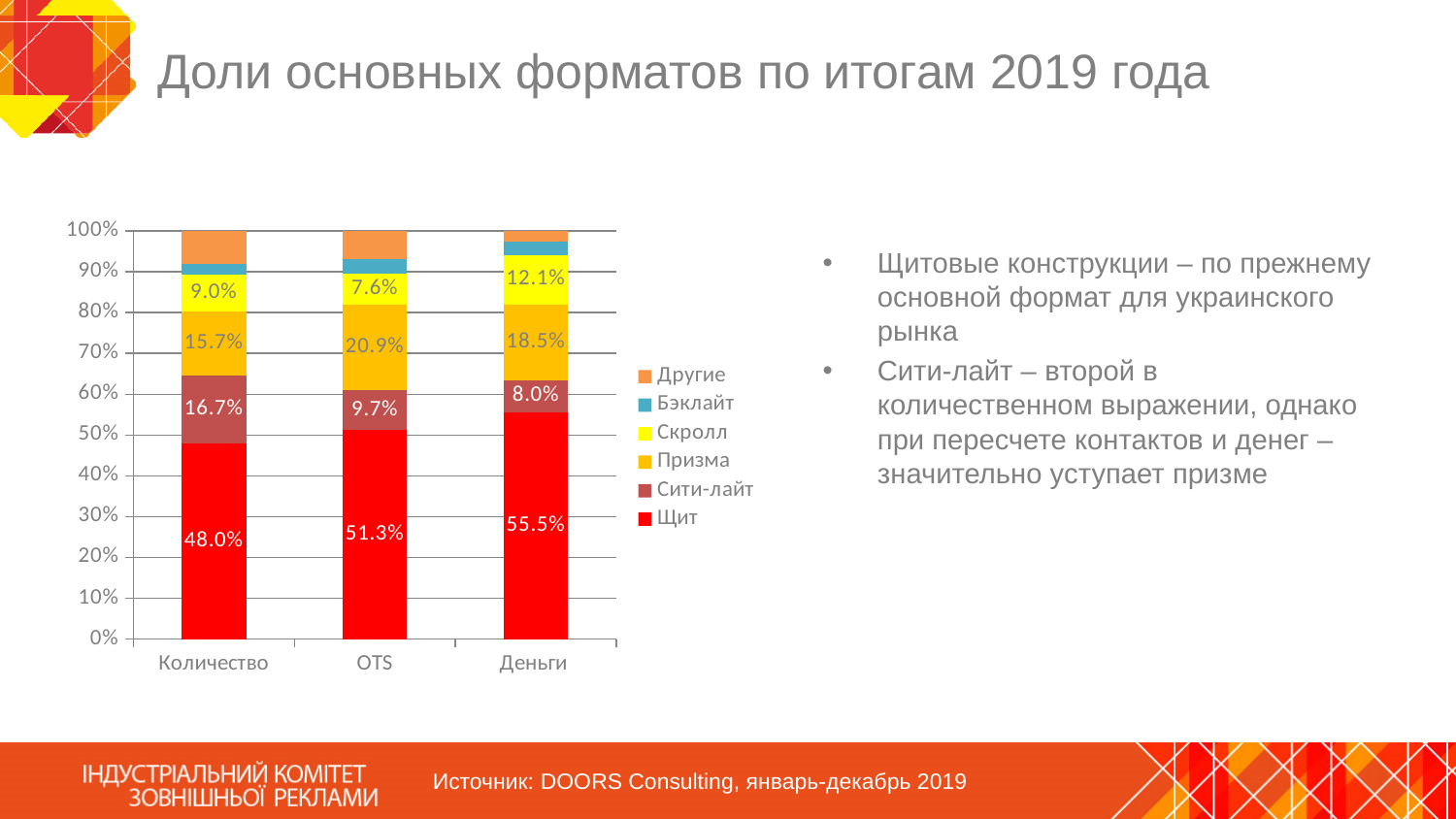
What is the difference between the Щит values for Деньги and Количество? 7.5% What kind of chart is shown on the slide? Stacked bar chart How many series does the legend list? 6 Which category has the highest value for Щит? Деньги Does the value of Щит rise or fall from Количество to Деньги? Rise How many categories are shown on the x axis? 3 What is the value of Призма for Деньги? 18.5% What is the value of Щит for Количество? 48.0% Which category has the lowest value for Сити-лайт? Деньги What is the value of Скролл for Деньги? 12.1% Which is larger: Призма for OTS or Призма for Количество? Призма for OTS What is the value of Сити-лайт for OTS? 9.7%